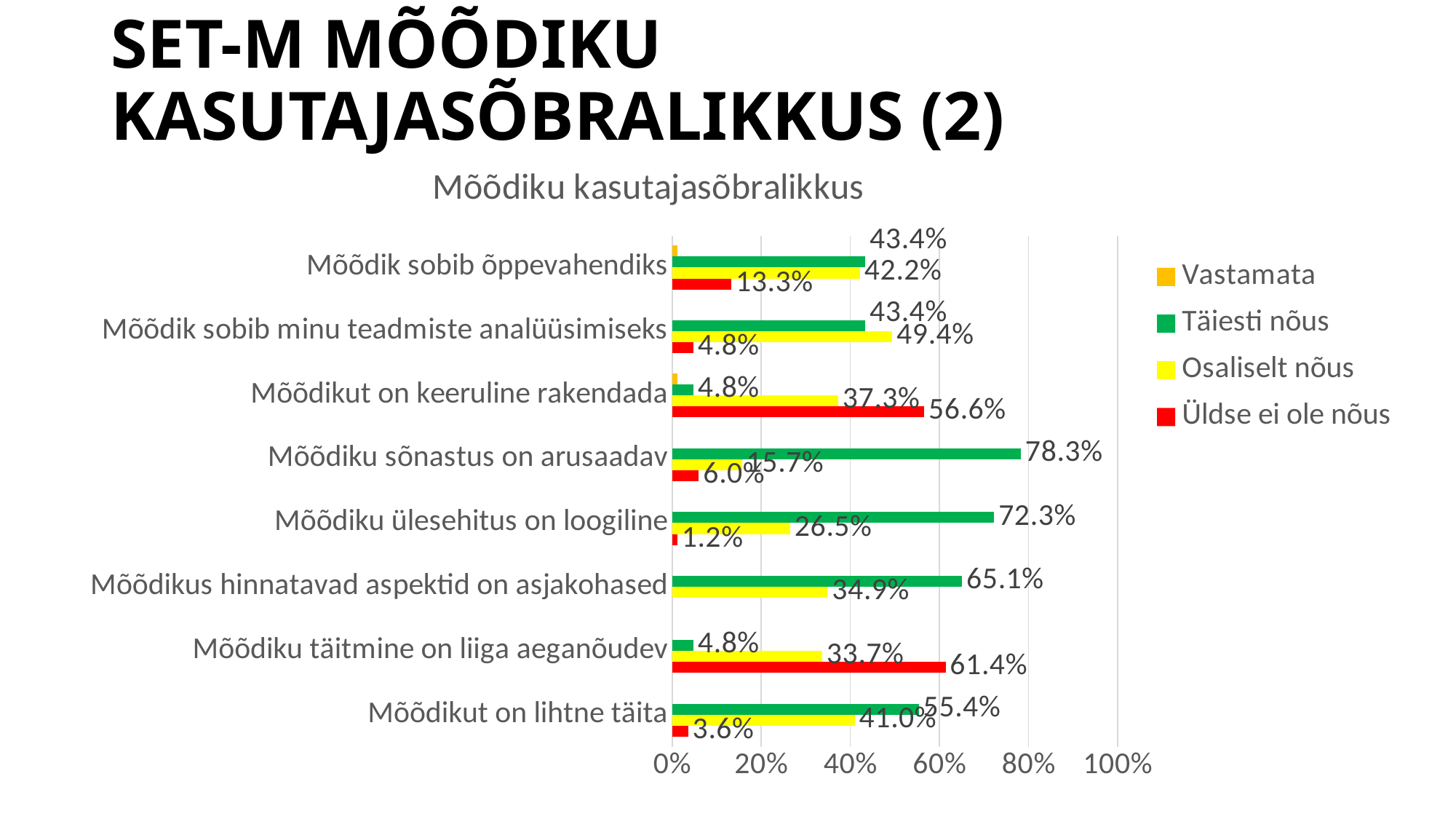
Is the 'Täiesti nõus' value for 'Mõõdikus hinnatavad aspektid on asjakohased' greater or less than 60%? greater What is the title of the chart? Mõõdiku kasutajasõbralikkus What is the 'Täiesti nõus' value for 'Mõõdiku sõnastus on arusaadav'? 78.3% What is the difference between the 'Täiesti nõus' and 'Osaliselt nõus' values for 'Mõõdikut on lihtne täita'? 14.4% How many categories (statements) are shown on the chart? 8 For 'Mõõdikut on keeruline rakendada', which is larger: 'Osaliselt nõus' or 'Üldse ei ole nõus'? Üldse ei ole nõus How many series does the legend list? 4 What is the 'Osaliselt nõus' value for 'Mõõdik sobib minu teadmiste analüüsimiseks'? 49.4% What is the 'Üldse ei ole nõus' value for 'Mõõdiku täitmine on liiga aeganõudev'? 61.4% Which statement has the highest 'Täiesti nõus' value? Mõõdiku sõnastus on arusaadav Which statement has the lowest 'Üldse ei ole nõus' value? Mõõdiku ülesehitus on loogiline What type of chart is shown on the slide? bar chart